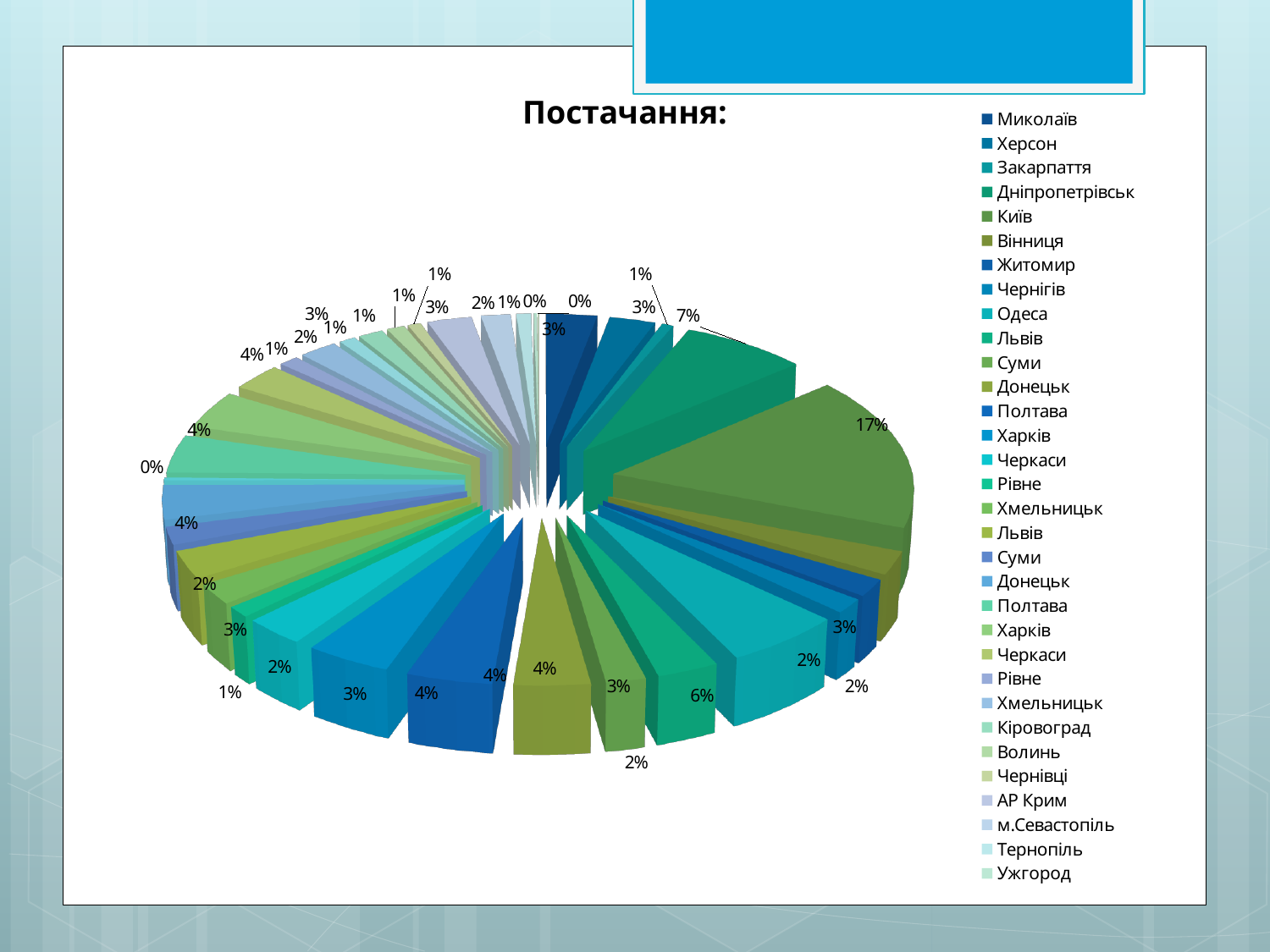
What is the smallest percentage label shown on the pie? 0% What share of the pie does Дніпропетрівськ have? 7% How many entries does the chart's legend list? 32 What is the largest percentage shown on any slice of the pie? 17% What is the title of the chart? Постачання: Which has the larger share, Київ or Дніпропетрівськ? Київ Which legend entry is listed first? Миколаїв What kind of chart is shown on the slide? pie chart By how many percentage points does the Київ slice exceed the Дніпропетрівськ slice? 10% What share of the pie does Київ have? 17% What share of the pie does Миколаїв have? 3%